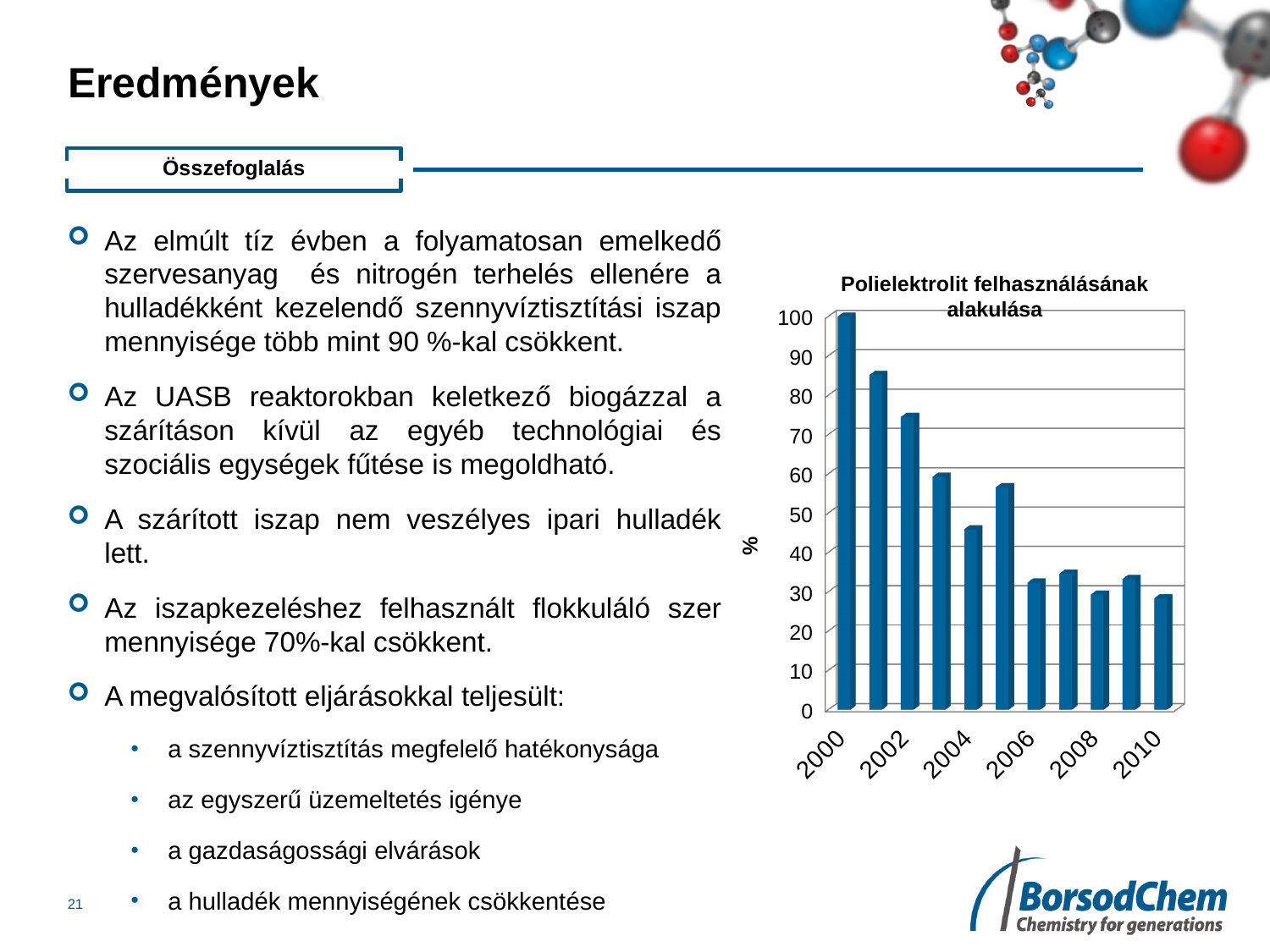
What kind of chart is shown on the slide? bar chart Is the value for 2004 greater or less than 50? less Is the value for 2010 greater or less than 40? less Which year has the larger value, 2002 or 2006? 2002 Is the value for 2006 greater or less than 40? less How many bars are plotted in the chart? 11 Which year has the highest value in the chart? 2000 What is the label on the vertical axis of the chart? % Do the values in the chart generally rise or fall from 2000 to 2010? fall What is the title of the chart? Polielektrolit felhasználásának alakulása What is the value for 2000 in the chart? 100